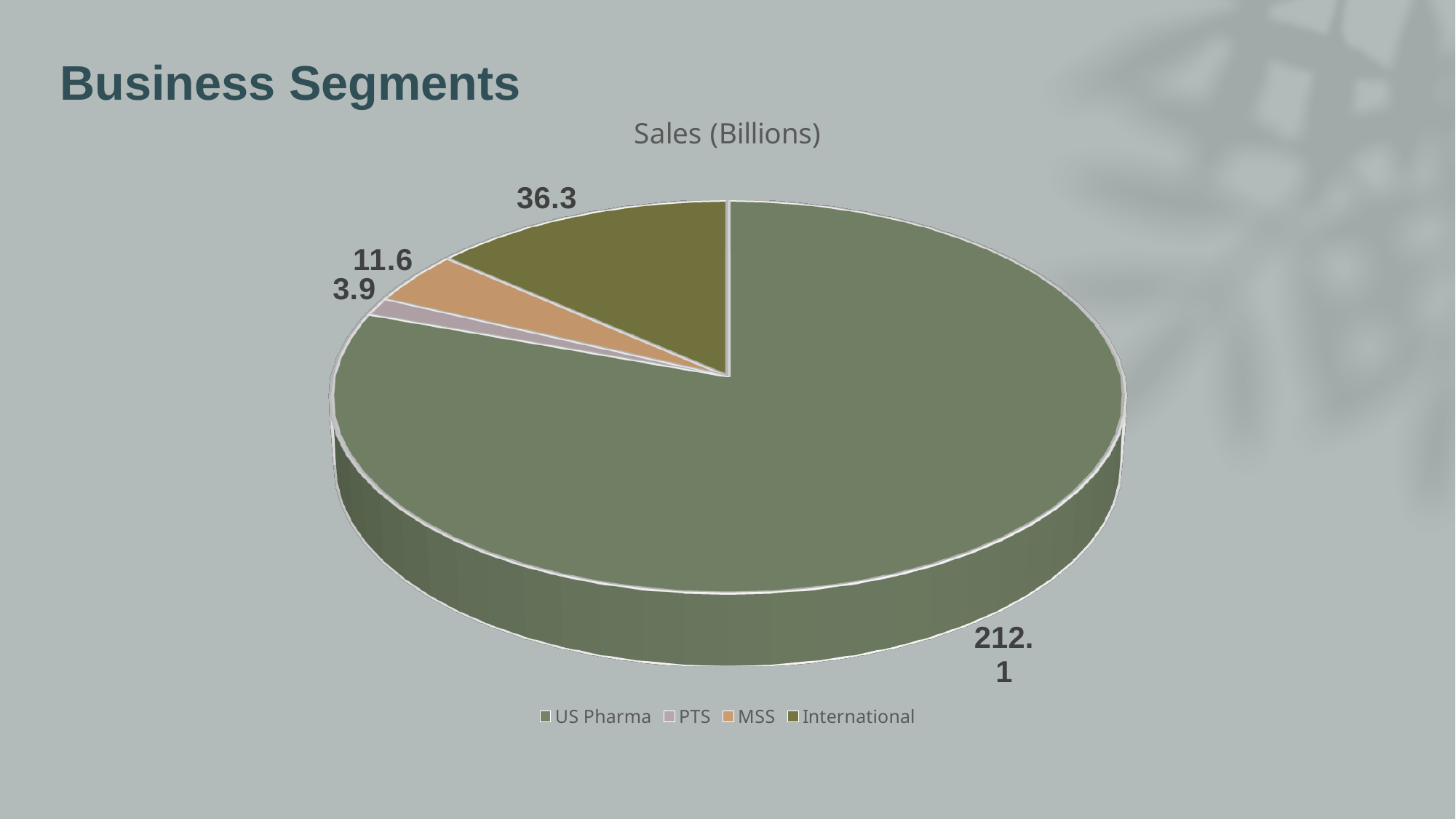
What is the value for MSS in the Sales (Billions) pie chart? 11.6 What is the title of the chart on the slide? Sales (Billions) Which segment has the largest slice in the Sales (Billions) pie chart? US Pharma What is the difference between the International and MSS values in the Sales (Billions) chart? 24.7 What is the value for PTS in the Sales (Billions) pie chart? 3.9 How many segments are shown in the Sales (Billions) pie chart? 4 Which is larger in the Sales (Billions) chart, MSS or PTS? MSS What is the difference between the US Pharma and International values in the Sales (Billions) chart? 175.8 What is the value for US Pharma in the Sales (Billions) pie chart? 212.1 What is the value for International in the Sales (Billions) pie chart? 36.3 Which segment has the smallest slice in the Sales (Billions) pie chart? PTS What type of chart is shown on the slide? Pie chart